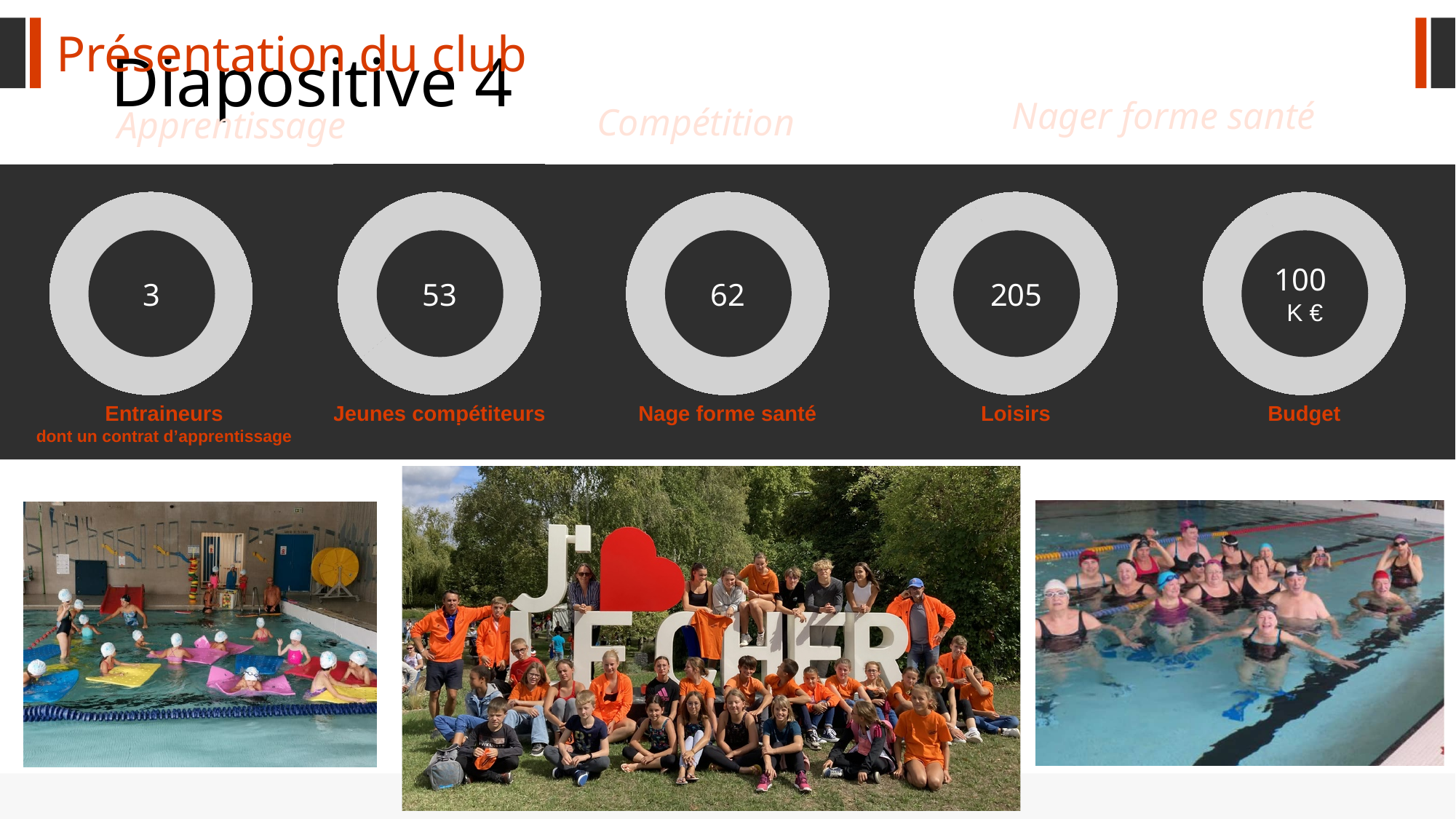
What value is shown in the circle labelled Jeunes compétiteurs? 53 What additional note is printed under the Entraineurs label? dont un contrat d'apprentissage What value is shown in the circle labelled Nage forme santé? 62 Which is larger, the value for Jeunes compétiteurs or the value for Nage forme santé? Nage forme santé How many circular indicators are shown in the dark band of the slide? 5 Among Entraineurs, Jeunes compétiteurs, Nage forme santé and Loisirs, which category has the lowest value? Entraineurs What is the difference between the Nage forme santé value and the Jeunes compétiteurs value? 9 What value is shown in the circle labelled Entraineurs? 3 Among Entraineurs, Jeunes compétiteurs, Nage forme santé and Loisirs, which category has the highest value? Loisirs What is the difference between the Loisirs value and the Nage forme santé value? 143 What value is shown in the circle labelled Budget? 100 K € What value is shown in the circle labelled Loisirs? 205